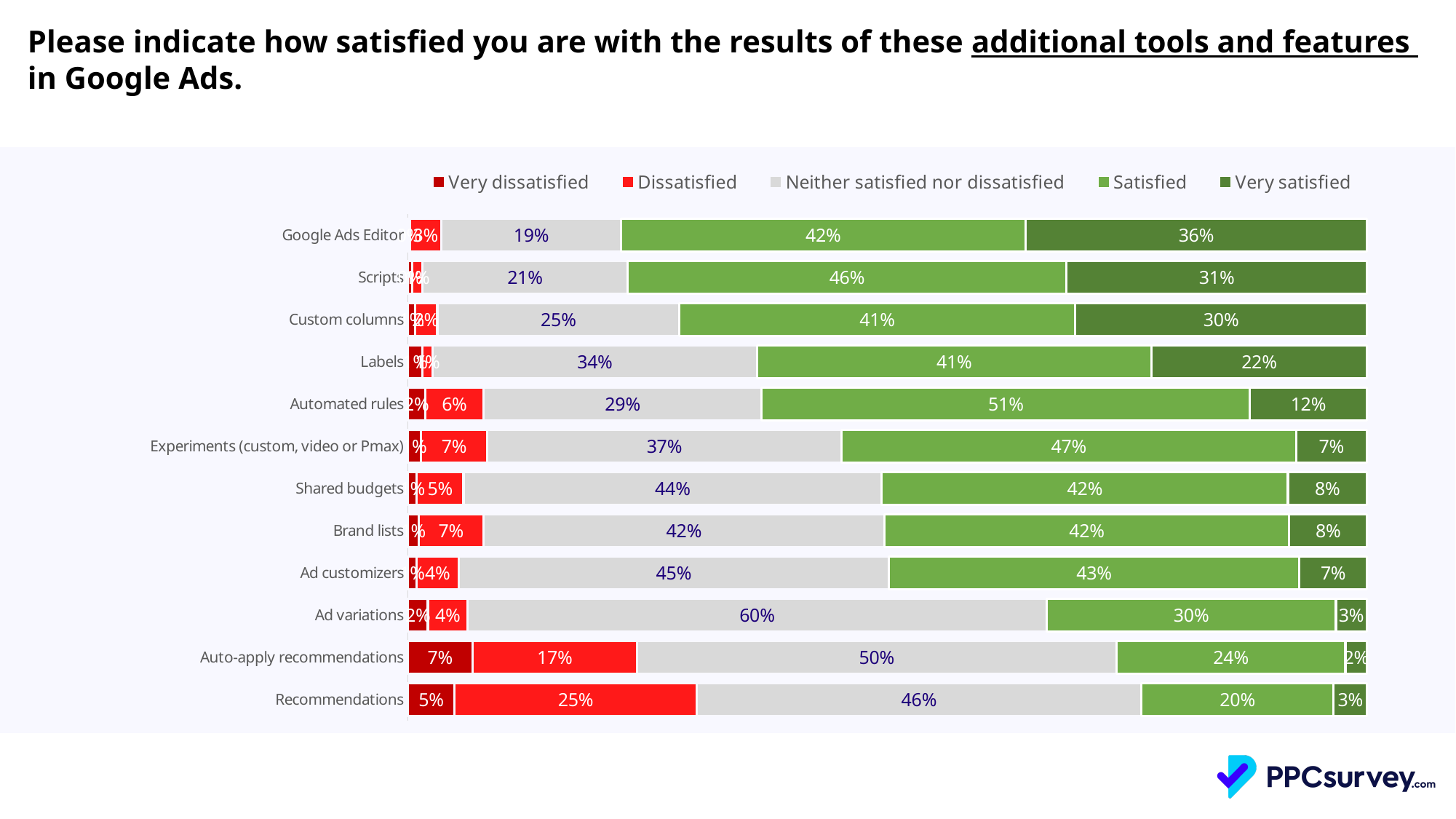
What is the Satisfied percentage for Automated rules? 51% What is the Very dissatisfied percentage for Auto-apply recommendations? 7% What kind of chart is shown on the slide? Stacked bar chart What percentage of respondents are Very satisfied with Google Ads Editor? 36% Which has a larger Neither satisfied nor dissatisfied percentage, Labels or Shared budgets? Shared budgets Which tool or feature has the highest Dissatisfied percentage? Recommendations What is the Dissatisfied percentage for Recommendations? 25% How many series does the legend list? 5 How many tools or features are listed on the chart? 12 What is the difference between the Satisfied percentages for Scripts and Recommendations? 26% Which tool or feature has the highest Very satisfied percentage? Google Ads Editor What is the Neither satisfied nor dissatisfied percentage for Ad variations? 60%